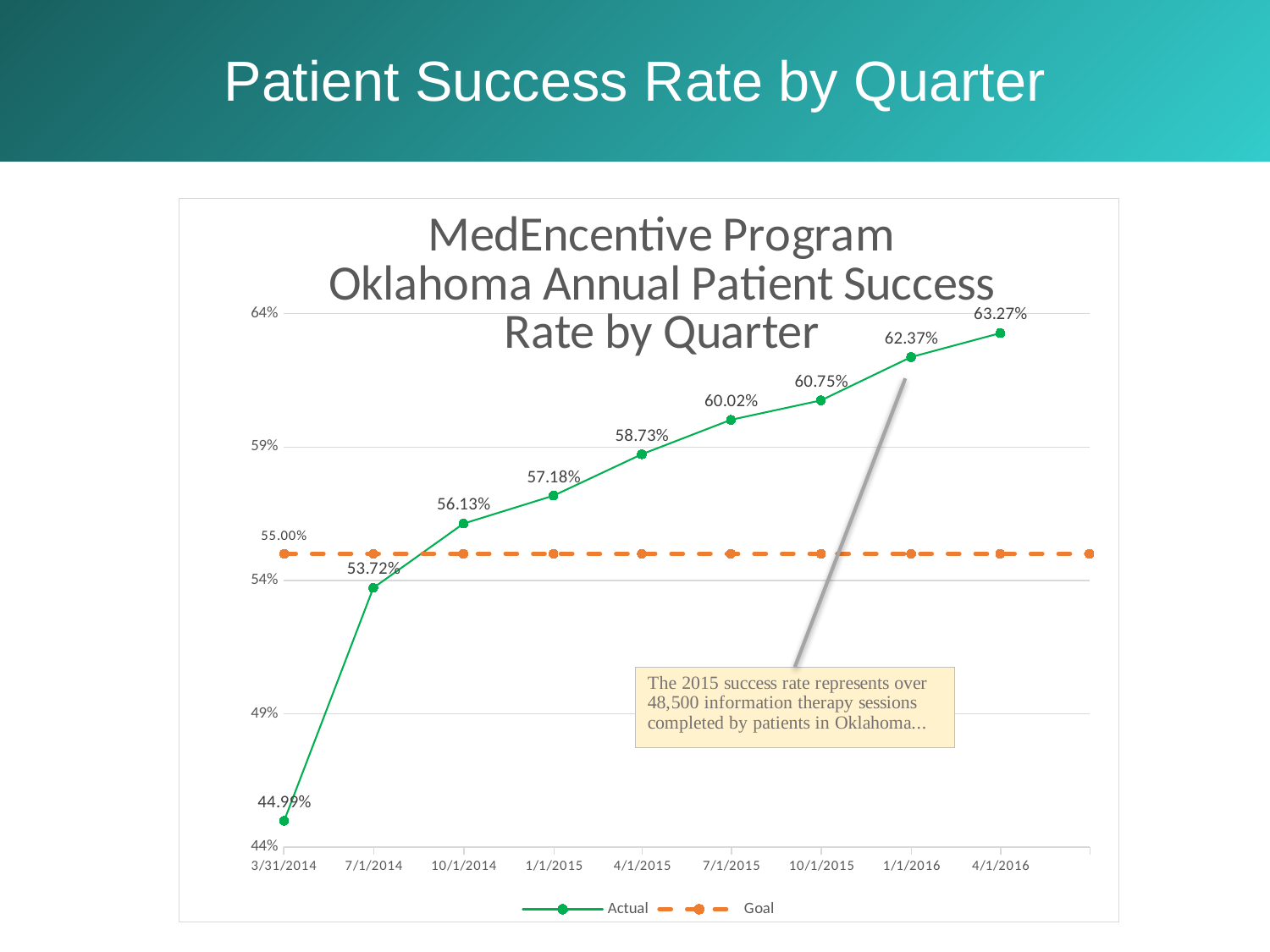
What is the difference between the Actual rates for 4/1/2016 and 1/1/2016? 0.90% What kind of chart is shown on the slide? line chart Is the Actual rate for 10/1/2014 greater or less than 54%? greater What is the Goal value shown on the chart? 55.00% What is the Actual patient success rate for 1/1/2015? 57.18% Which quarter has the highest Actual patient success rate? 4/1/2016 What is the Actual patient success rate for 7/1/2014? 53.72% Which quarter has the lowest Actual patient success rate? 3/31/2014 Does the Actual patient success rate rise or fall from 3/31/2014 to 4/1/2016? rise What is the Actual patient success rate for 4/1/2016? 63.27% How many series does the legend list? 2 Is the Actual rate for 7/1/2014 higher or lower than the Goal? lower